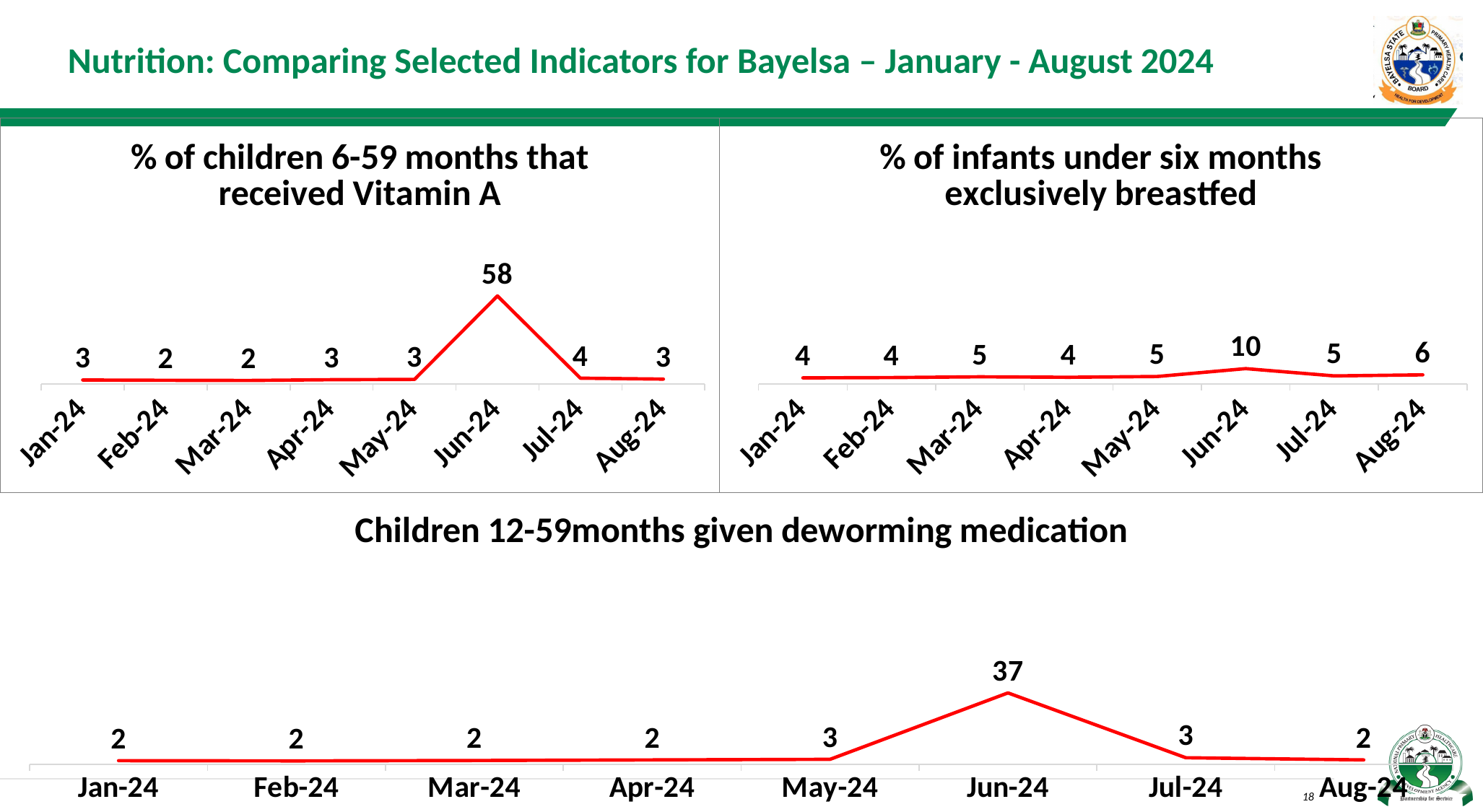
In the '% of infants under six months exclusively breastfed' chart, which month has the highest value? Jun-24 In the '% of infants under six months exclusively breastfed' chart, what is the value for Aug-24? 6 In the '% of children 6-59 months that received Vitamin A' chart, what is the difference between the Jun-24 and Jul-24 values? 54 In the 'Children 12-59months given deworming medication' chart, what is the difference between the Jun-24 and Jul-24 values? 34 In the '% of children 6-59 months that received Vitamin A' chart, what is the value for Jun-24? 58 In the 'Children 12-59months given deworming medication' chart, what is the value for May-24? 3 In the 'Children 12-59months given deworming medication' chart, is the value for Jun-24 larger than the value for Jan-24? Yes In the '% of children 6-59 months that received Vitamin A' chart, which month has the highest value? Jun-24 In the '% of infants under six months exclusively breastfed' chart, what is the value for Jun-24? 10 In the '% of infants under six months exclusively breastfed' chart, how many months are plotted? 8 In the 'Children 12-59months given deworming medication' chart, what is the value for Jun-24? 37 What type of chart is the 'Children 12-59months given deworming medication' chart? Line chart